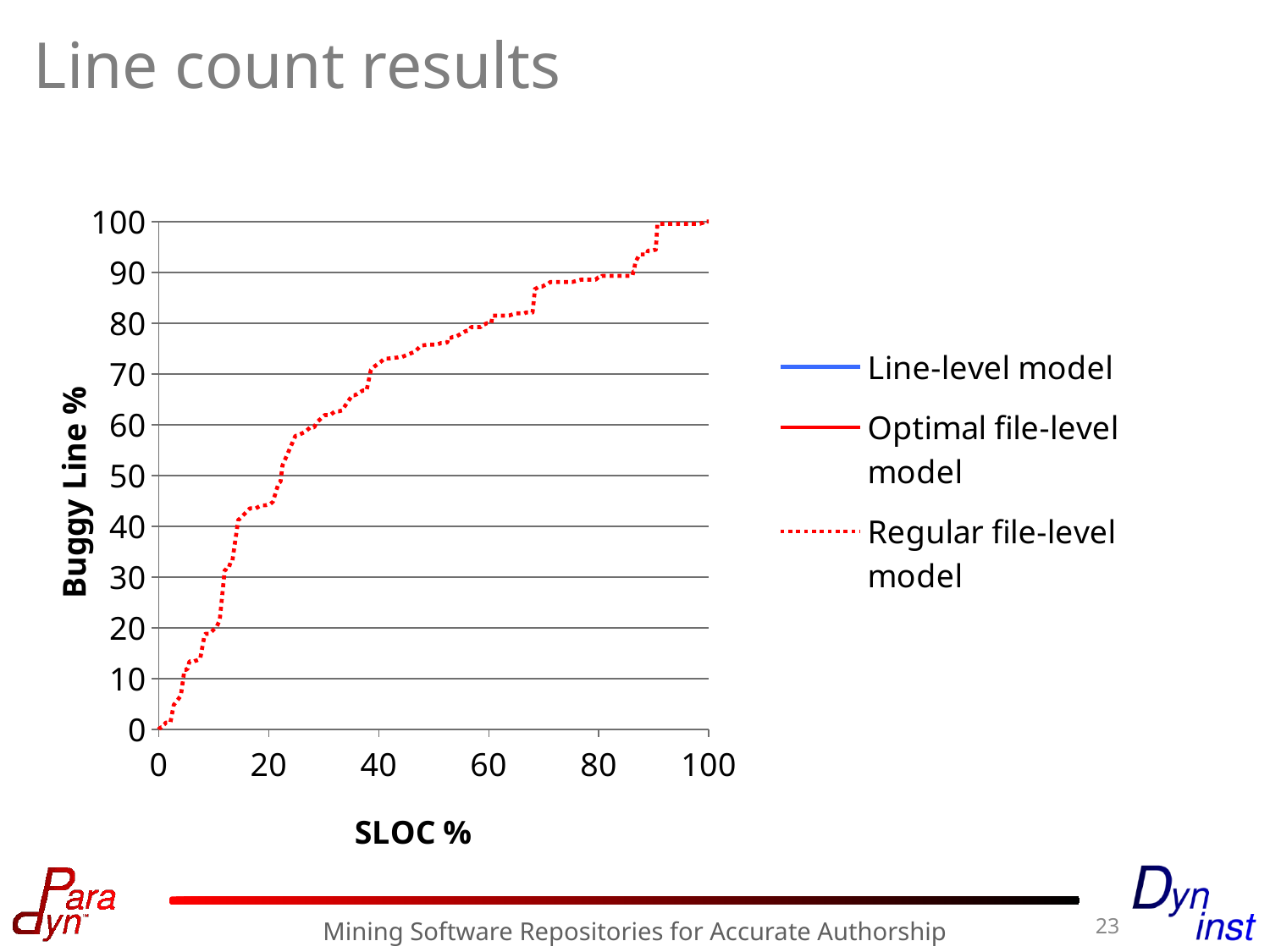
What is the title of the chart's x axis? SLOC % Is the Buggy Line % value of the Regular file-level model at SLOC % = 20 greater or less than 30? greater Is the Buggy Line % value of the Regular file-level model at SLOC % = 60 greater or less than 70? greater Which legend entry is shown with a dotted line? Regular file-level model Is the Buggy Line % value of the Regular file-level model at SLOC % = 80 greater or less than 80? greater What is the Buggy Line % value of the Regular file-level model at SLOC % = 100? 100 What is the Buggy Line % value of the Regular file-level model at SLOC % = 0? 0 How many series does the legend list? 3 What kind of chart is shown on the slide? line chart What is the title of the chart's y axis? Buggy Line % Does the Regular file-level model line rise or fall as SLOC % increases? rise